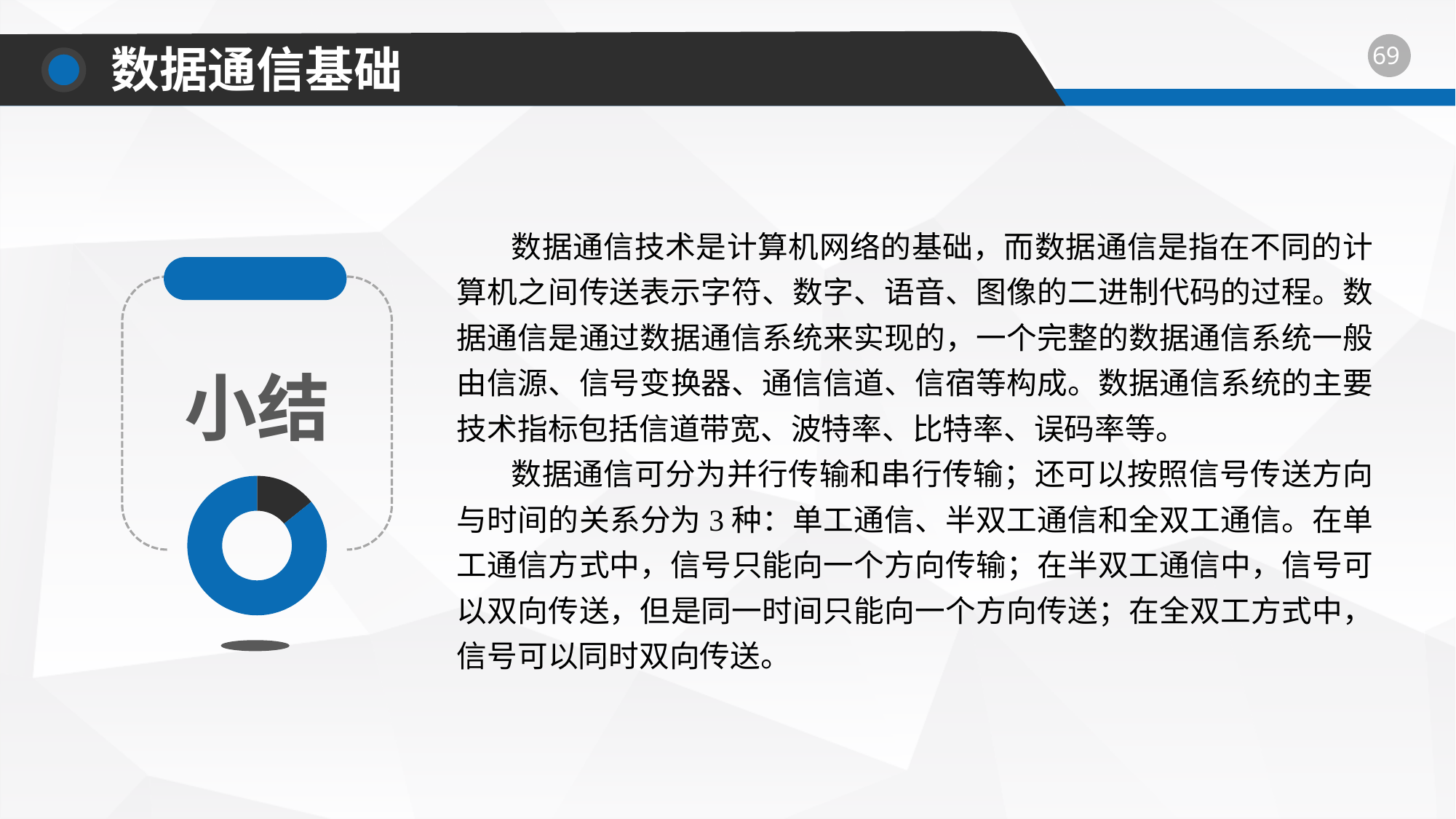
What kind of chart is shown on the left side of the slide below the word 小结? doughnut chart Does the doughnut chart on the left of the slide show any data labels or a legend? No In the doughnut chart on the left of the slide, which slice is larger, the blue one or the dark grey one? the blue one How many slices does the doughnut chart on the left of the slide have? 2